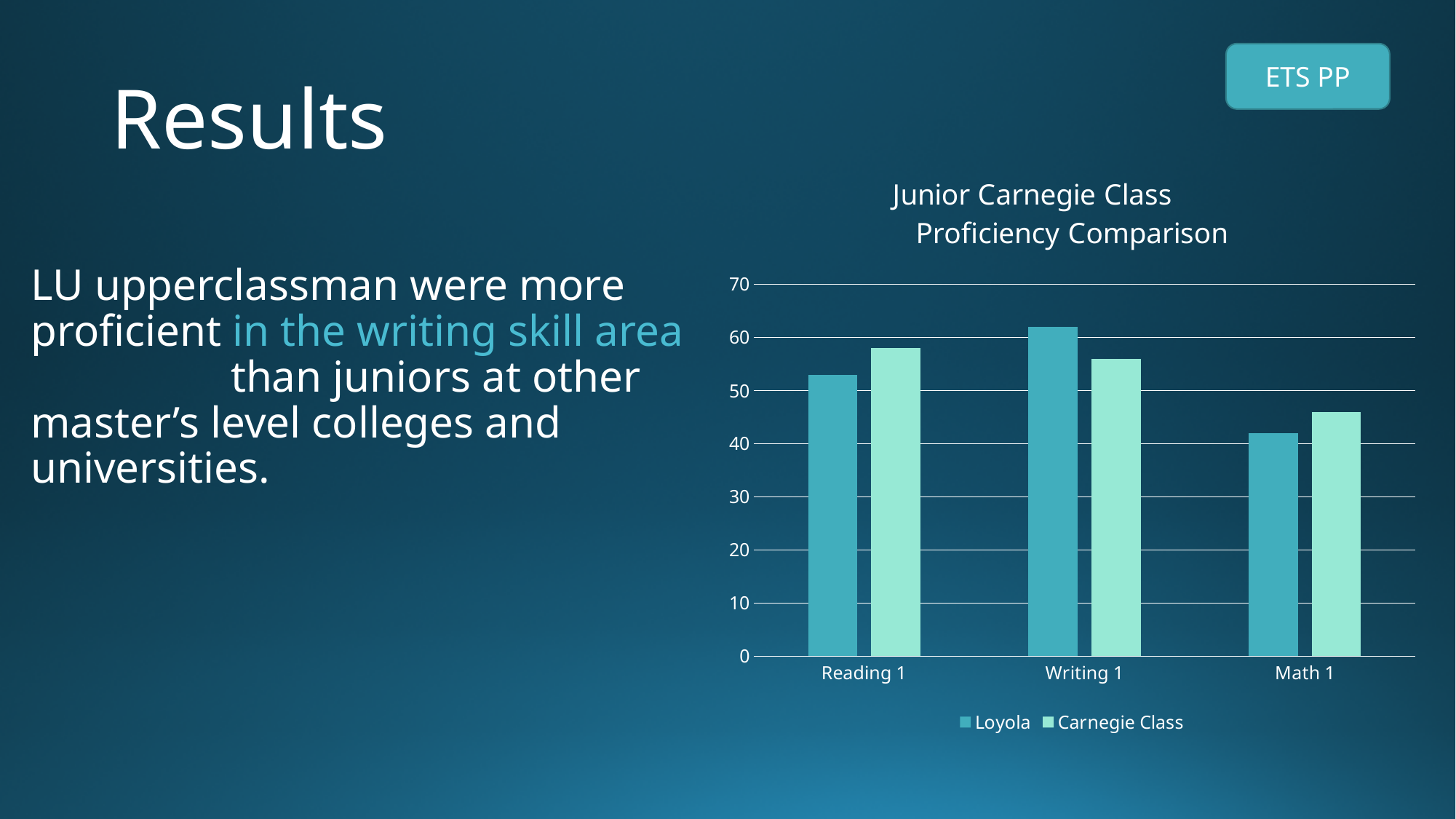
Is the Carnegie Class value for Math 1 greater or less than 50? less Is the Loyola value for Writing 1 greater or less than 60? greater In which category is the Loyola value highest? Writing 1 What kind of chart is shown on the slide? bar chart In which category is the Loyola value lowest? Math 1 What is the title of the chart? Junior Carnegie Class Proficiency Comparison For Math 1, which is larger: Loyola or Carnegie Class? Carnegie Class For Reading 1, which is larger: Loyola or Carnegie Class? Carnegie Class Which two series are listed in the chart's legend? Loyola and Carnegie Class How many series does the chart's legend list? 2 For Writing 1, which is larger: Loyola or Carnegie Class? Loyola How many categories are shown on the x axis of the chart? 3